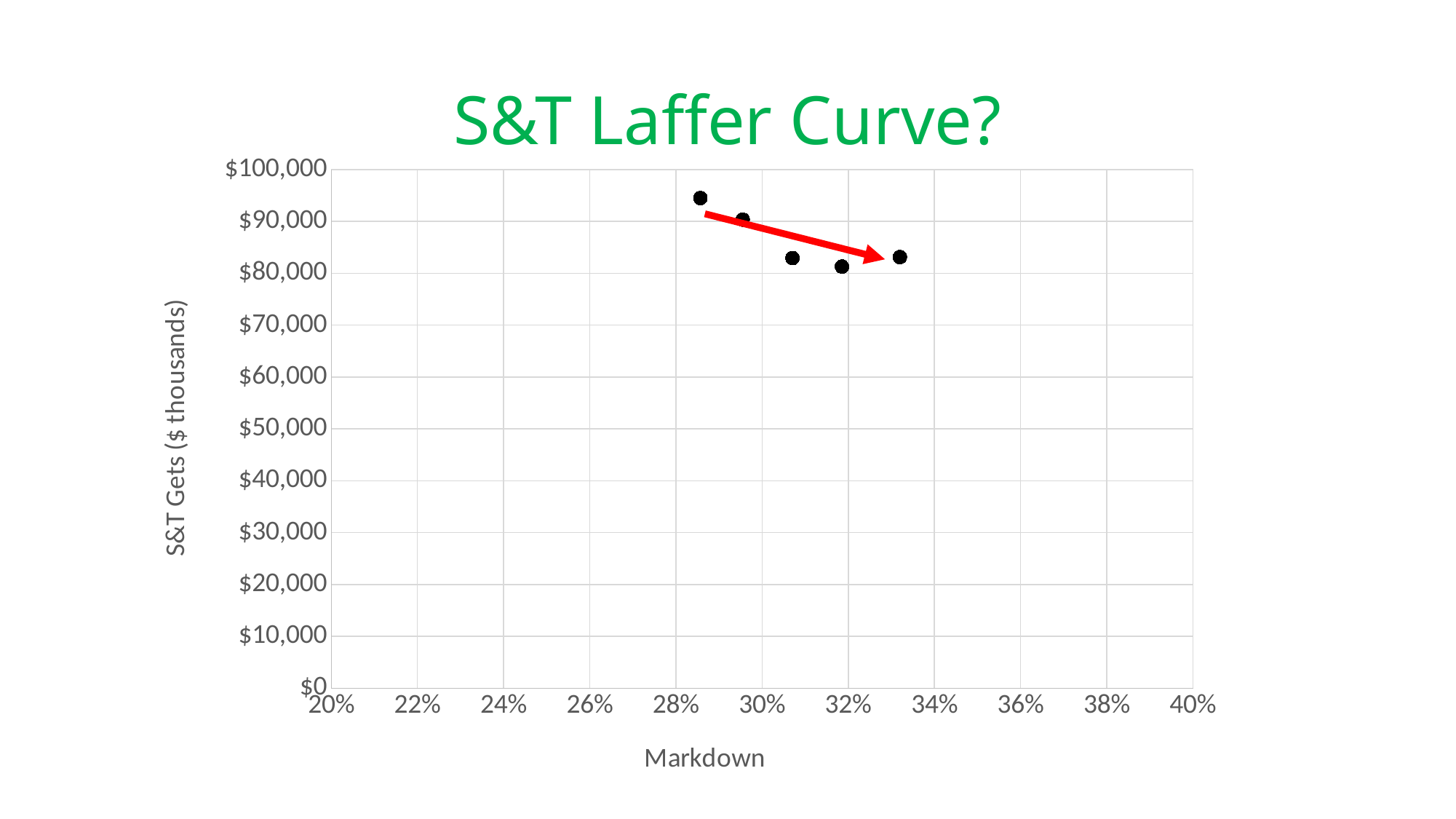
Are all plotted points above $70,000? yes What kind of chart is shown on the slide? scatter chart How many data points are plotted on the chart? 5 Is the value for the point near 32% markdown greater or less than $90,000? less Is the value for the leftmost point (near 28% markdown) greater or less than $90,000? greater Which point has the highest value on the chart? the leftmost point, near 28% markdown What is the title of the chart? S&T Laffer Curve? Do the plotted values generally rise or fall as Markdown increases? fall Which point has the highest S&T Gets value: the one near 28% markdown or the one near 33% markdown? the one near 28% markdown What is the label of the x axis? Markdown